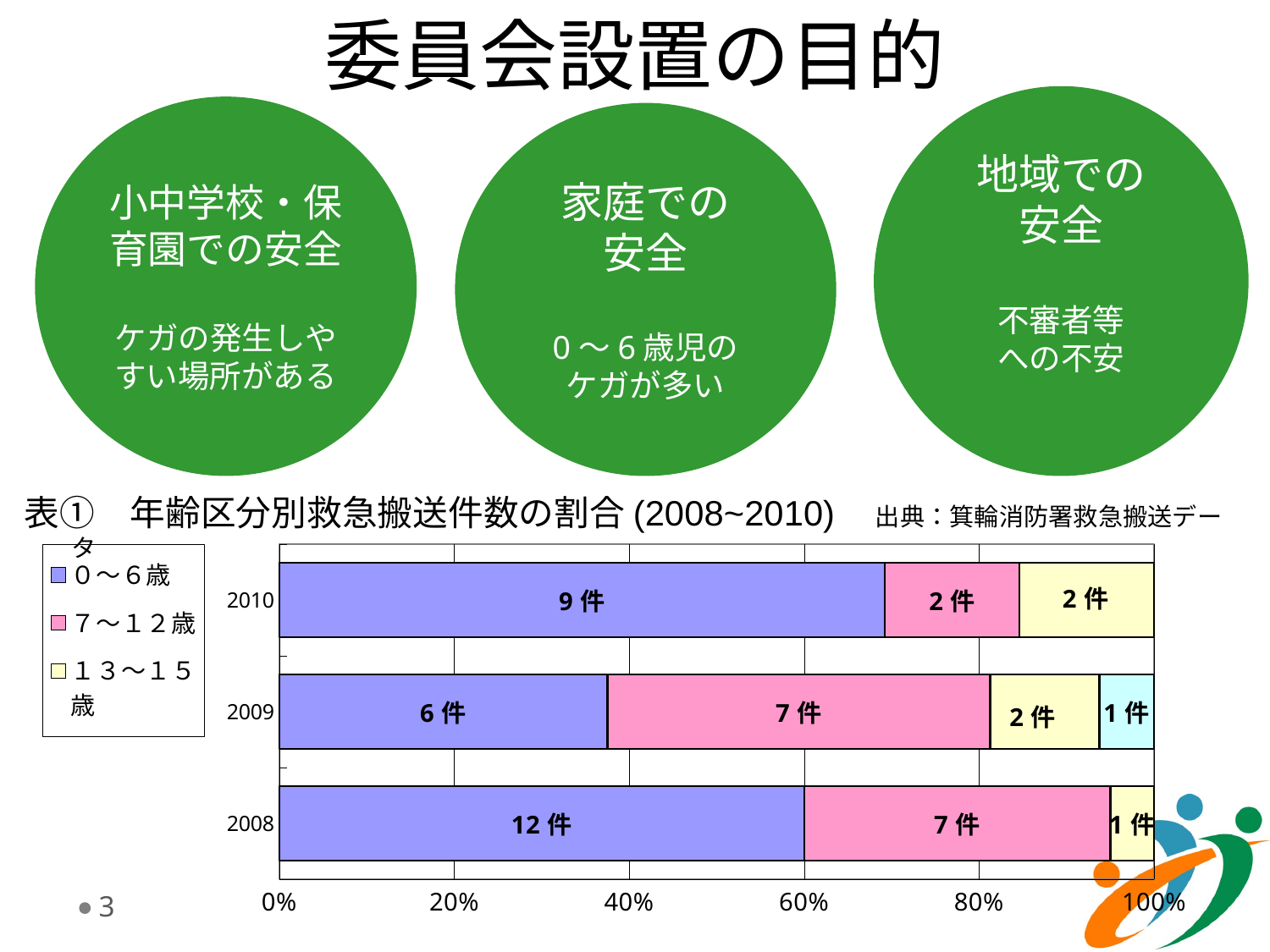
What kind of chart is shown on the slide? Stacked bar chart What is the difference between the 0～6歳 values for 2008 and 2010? 3件 In which year is the 0～6歳 segment the largest? 2008 How many years (bars) are shown in the chart? 3 What is the value for the 7～12歳 segment in 2009? 7件 What is the value for the 13～15歳 segment in 2008? 1件 Which is larger in 2009: the 0～6歳 segment or the 7～12歳 segment? 7～12歳 In which year is the 0～6歳 segment the smallest? 2009 What is the value for the 0～6歳 segment in 2010? 9件 How many series does the legend list? 3 What is the total of all segments in the 2010 bar? 13件 What is the value for the 0～6歳 segment in 2008? 12件